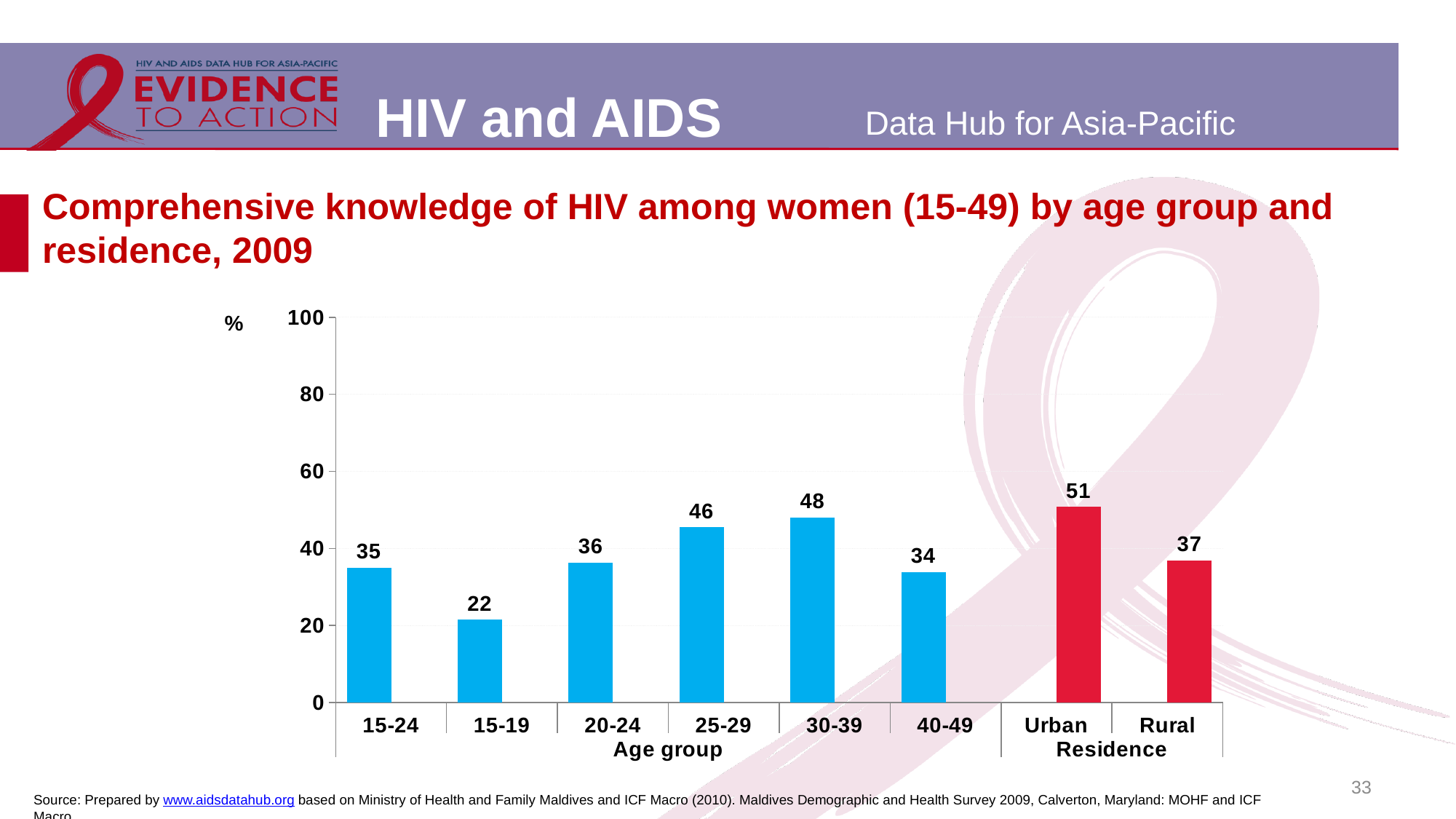
What is the difference between the Urban and Rural values? 14 Is the value for the 15-19 age group greater or less than 40? less Which is larger, the value for 25-29 or the value for 20-24? 25-29 What is the difference between the 30-39 and 40-49 age groups? 14 What type of chart is shown on the slide? bar chart What is the value for the 15-19 age group? 22 Which category has the highest value? Urban What is the value for Urban residence? 51 What colour are the bars for the Residence categories? red How many bars are shown in the chart? 8 Which category has the lowest value? 15-19 What is the value for the 30-39 age group? 48